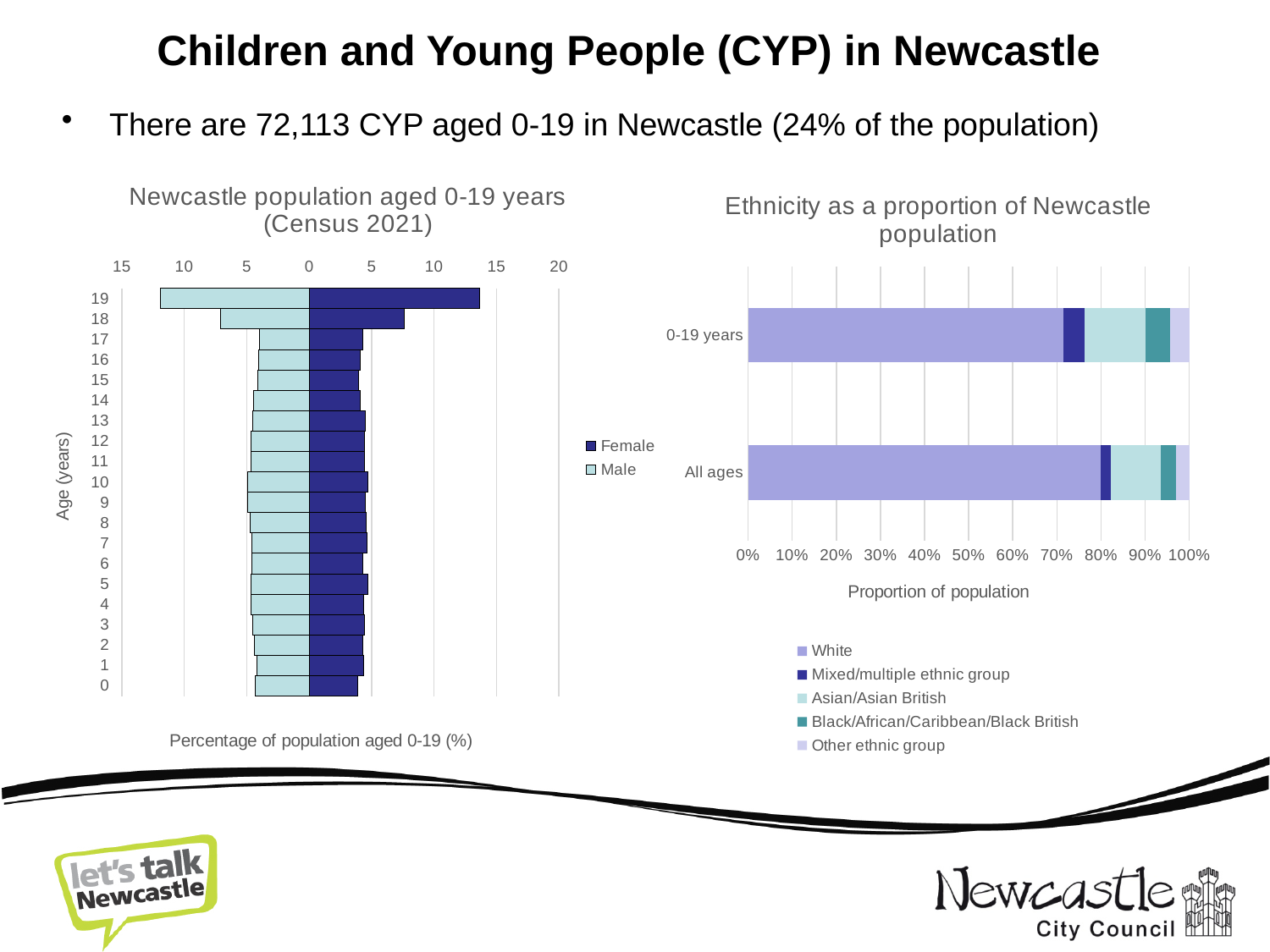
How many age categories are shown on the 'Newcastle population aged 0-19 years (Census 2021)' chart? 20 In the 'Newcastle population aged 0-19 years (Census 2021)' chart, is the Male value for age 0 greater or less than 5? less In the 'Newcastle population aged 0-19 years (Census 2021)' chart, which is larger: the Female value for age 18 or the Female value for age 17? age 18 How many series does the legend of the 'Newcastle population aged 0-19 years (Census 2021)' chart list? 2 In the 'Newcastle population aged 0-19 years (Census 2021)' chart, which age has the highest Female value? 19 How many series does the legend of the 'Ethnicity as a proportion of Newcastle population' chart list? 5 What is the x-axis label of the 'Newcastle population aged 0-19 years (Census 2021)' chart? Percentage of population aged 0-19 (%) How many categories are shown on the 'Ethnicity as a proportion of Newcastle population' chart? 2 What kind of chart is the 'Newcastle population aged 0-19 years (Census 2021)' chart? bar chart In the 'Ethnicity as a proportion of Newcastle population' chart, which category has the larger White proportion: 0-19 years or All ages? All ages In the 'Newcastle population aged 0-19 years (Census 2021)' chart, is the Female value for age 19 greater or less than 10? greater In the 'Ethnicity as a proportion of Newcastle population' chart, is the White proportion for 0-19 years greater or less than 60%? greater